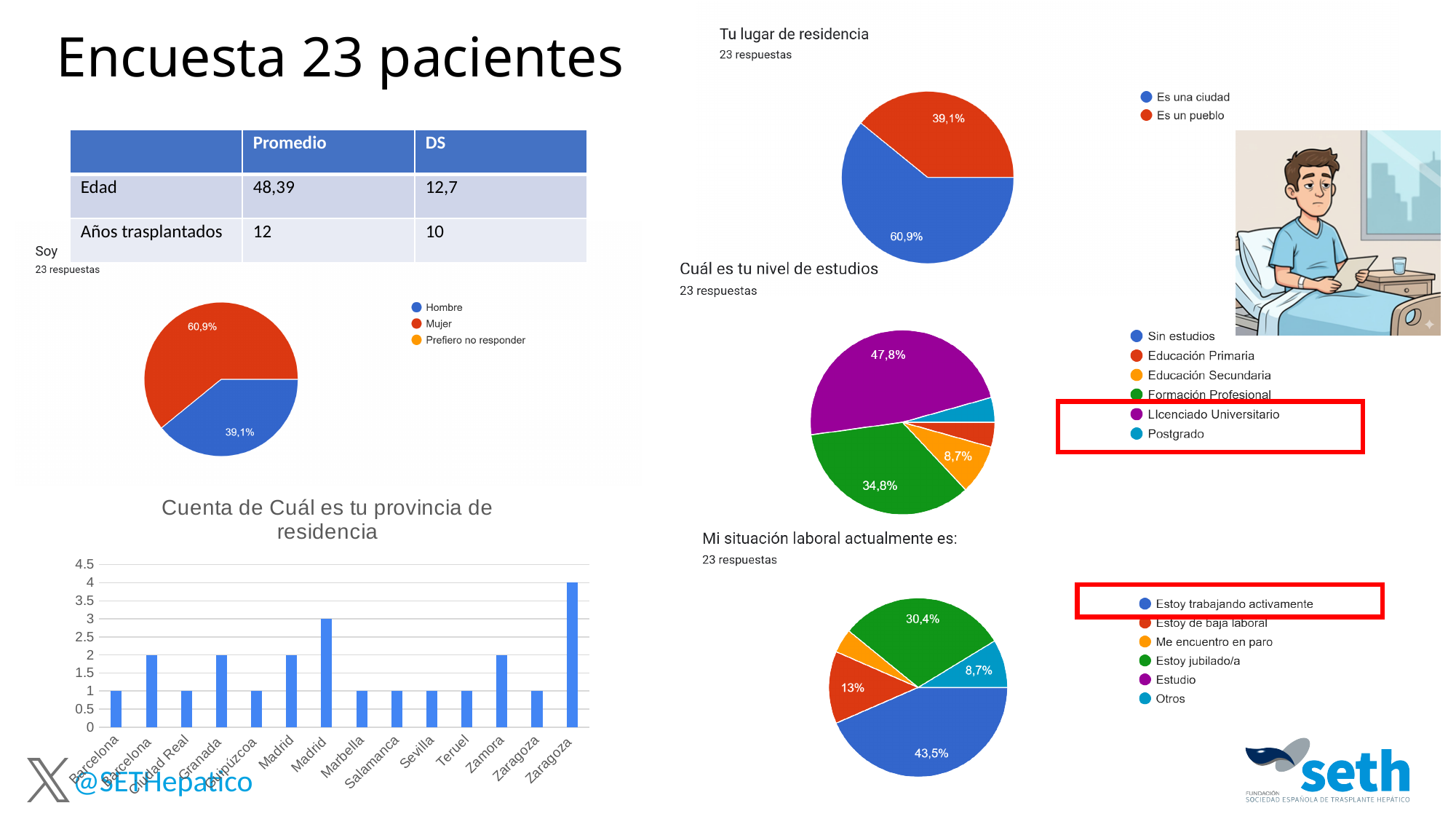
In the 'Tu lugar de residencia' pie chart, which category has the larger share, 'Es una ciudad' or 'Es un pueblo'? Es una ciudad In the 'Mi situación laboral actualmente es' pie chart, which category has the largest share? Estoy trabajando activamente How many categories does the legend of the 'Cuál es tu nivel de estudios' pie chart list? 6 In the 'Soy' pie chart, what percentage is shown for Hombre? 39,1% In the 'Cuenta de Cuál es tu provincia de residencia' bar chart, what is the value for Granada? 2 In the 'Cuál es tu nivel de estudios' pie chart, what percentage is shown for Licenciado Universitario? 47,8% In the 'Tu lugar de residencia' pie chart, what percentage of respondents answered 'Es una ciudad'? 60,9% What type of chart is 'Cuenta de Cuál es tu provincia de residencia'? Bar chart In the 'Soy' pie chart, what percentage is shown for Mujer? 60,9% In the 'Mi situación laboral actualmente es' pie chart, what percentage is shown for 'Estoy jubilado/a'? 30,4% In the 'Cuenta de Cuál es tu provincia de residencia' bar chart, what is the highest value shown? 4 In the 'Cuál es tu nivel de estudios' pie chart, what is the difference between the Licenciado Universitario share and the Formación Profesional share? 13 percentage points